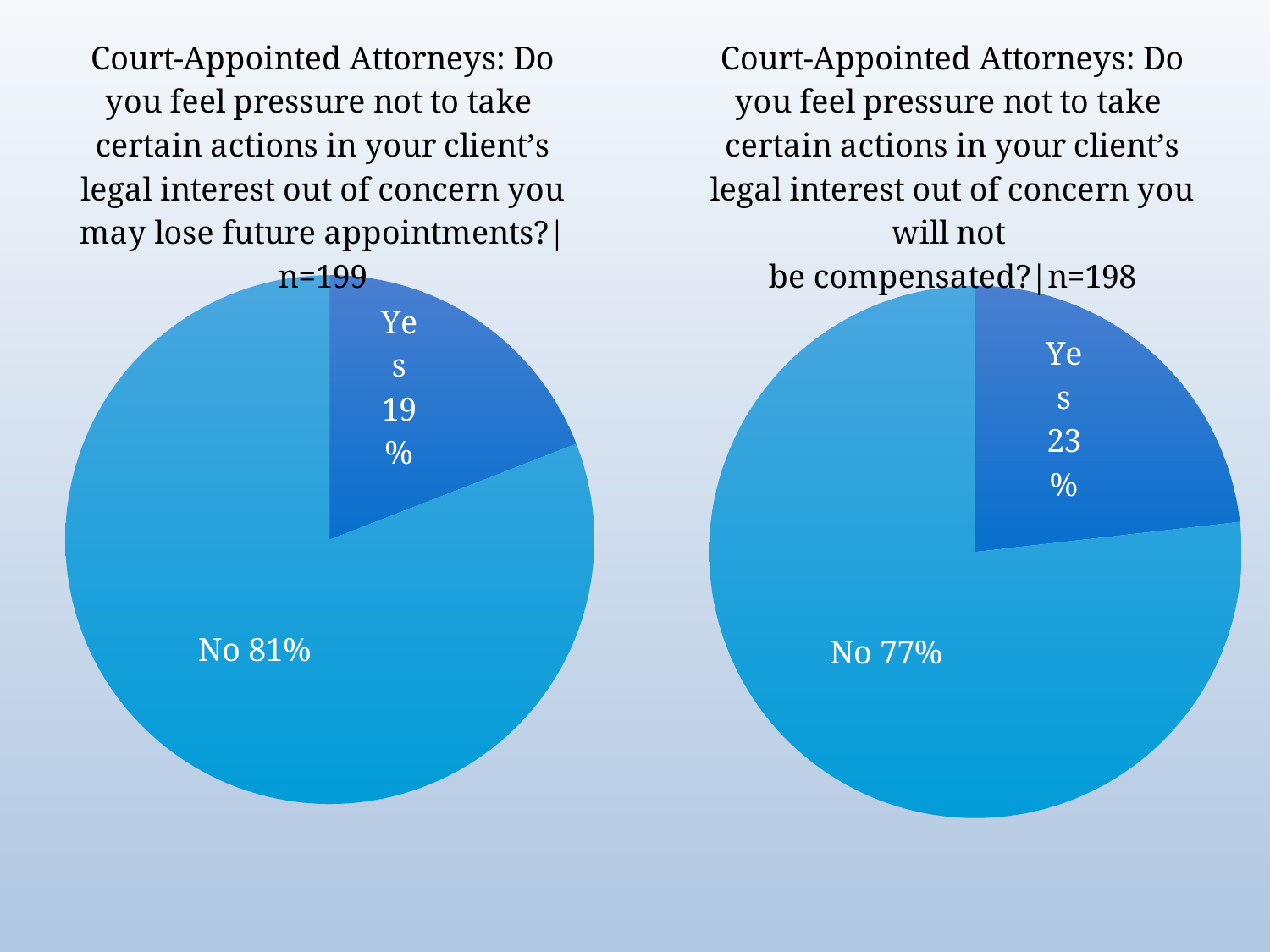
What type of chart is used on the left side of the slide? Pie chart In the right chart (about not being compensated), which response has the smallest share? Yes In the right chart (about not being compensated), what percentage of respondents answered Yes? 23% In the right chart (about not being compensated), what percentage of respondents answered No? 77% In the right chart (about not being compensated), what is the difference between the No and Yes percentages? 54% In the left chart (about losing future appointments), what is the difference between the No and Yes percentages? 62% In the left chart (about losing future appointments), which response has the largest share? No How many slices does the right chart (about not being compensated) have? 2 In the left chart (about losing future appointments), what percentage of respondents answered No? 81% Which chart has the larger Yes share, the left chart (losing future appointments) or the right chart (not being compensated)? The right chart (not being compensated) In the left chart (about losing future appointments), what percentage of respondents answered Yes? 19% What is the sample size (n) shown in the title of the left chart (about losing future appointments)? n=199